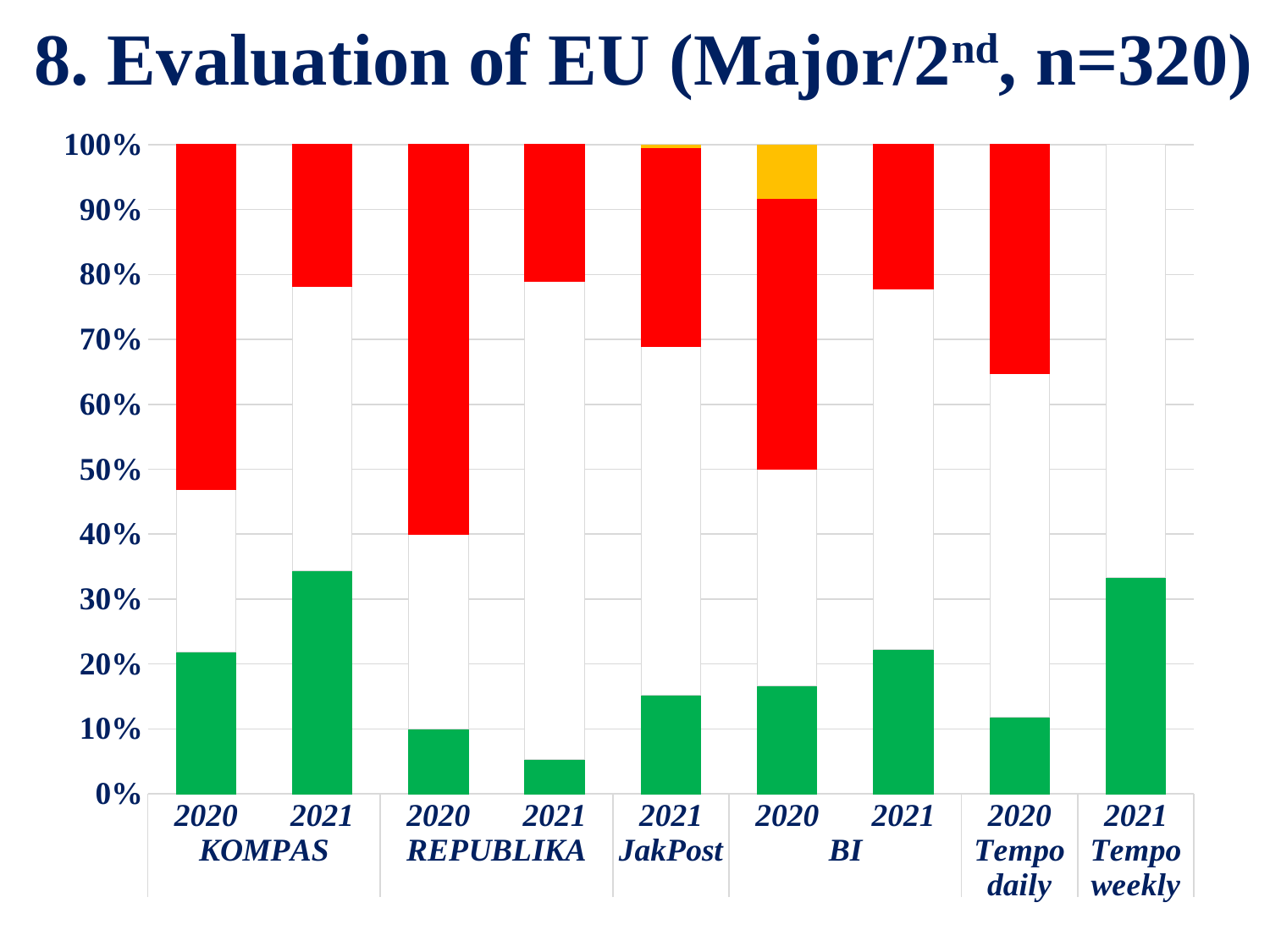
Which bar has the smallest green segment? 2021 REPUBLIKA What kind of chart is shown on the slide? Stacked bar chart Is the green segment for 2021 REPUBLIKA greater or less than 10%? less Which has the larger red segment, 2020 KOMPAS or 2021 KOMPAS? 2020 KOMPAS How many bars are plotted in the chart? 9 Is the green segment for 2020 KOMPAS greater or less than 20%? greater Is the green segment for 2021 KOMPAS greater or less than 30%? greater Which bar has the largest yellow segment? 2020 BI Which bar has the largest red segment? 2020 REPUBLIKA What is the title of the chart on the slide? 8. Evaluation of EU (Major/2nd, n=320) Which has the larger green segment, 2020 KOMPAS or 2020 REPUBLIKA? 2020 KOMPAS